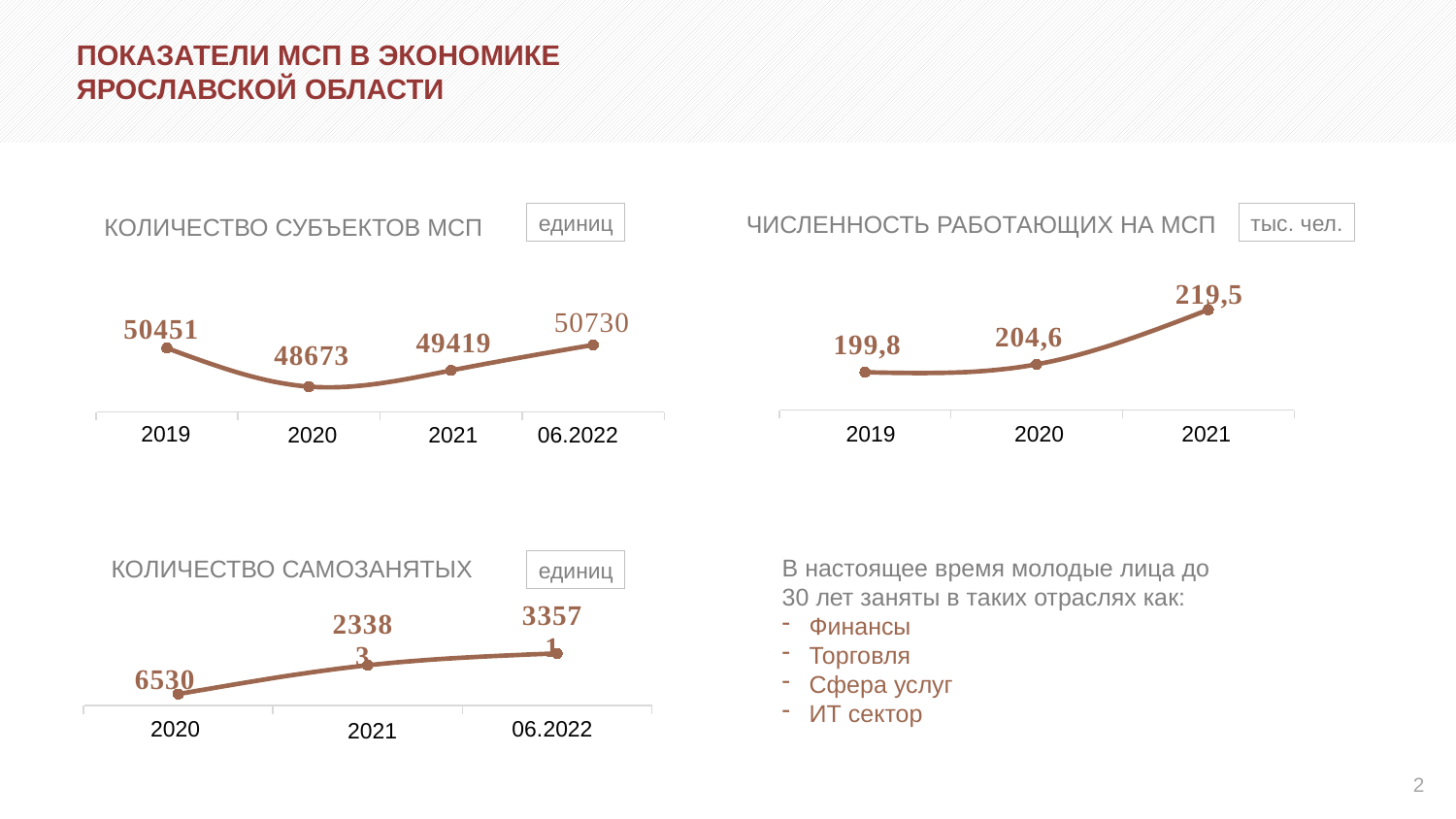
On the chart titled КОЛИЧЕСТВО СУБЪЕКТОВ МСП, which period has the highest value? 06.2022 On the chart titled КОЛИЧЕСТВО САМОЗАНЯТЫХ, what is the value for 2020? 6530 On the chart titled КОЛИЧЕСТВО СУБЪЕКТОВ МСП, what is the difference between the values for 06.2022 and 2021? 1311 On the chart titled ЧИСЛЕННОСТЬ РАБОТАЮЩИХ НА МСП, what unit is shown next to the title? тыс. чел. What type of chart is the chart titled КОЛИЧЕСТВО САМОЗАНЯТЫХ? line chart On the chart titled ЧИСЛЕННОСТЬ РАБОТАЮЩИХ НА МСП, what is the value for 2019? 199,8 On the chart titled КОЛИЧЕСТВО СУБЪЕКТОВ МСП, what is the value for 2020? 48673 On the chart titled ЧИСЛЕННОСТЬ РАБОТАЮЩИХ НА МСП, what is the value for 2021? 219,5 On the chart titled КОЛИЧЕСТВО СУБЪЕКТОВ МСП, what is the value for 2019? 50451 On the chart titled КОЛИЧЕСТВО СУБЪЕКТОВ МСП, which year has the lowest value? 2020 On the chart titled КОЛИЧЕСТВО СУБЪЕКТОВ МСП, how many data points are plotted? 4 On the chart titled ЧИСЛЕННОСТЬ РАБОТАЮЩИХ НА МСП, do the values rise or fall from 2019 to 2021? rise